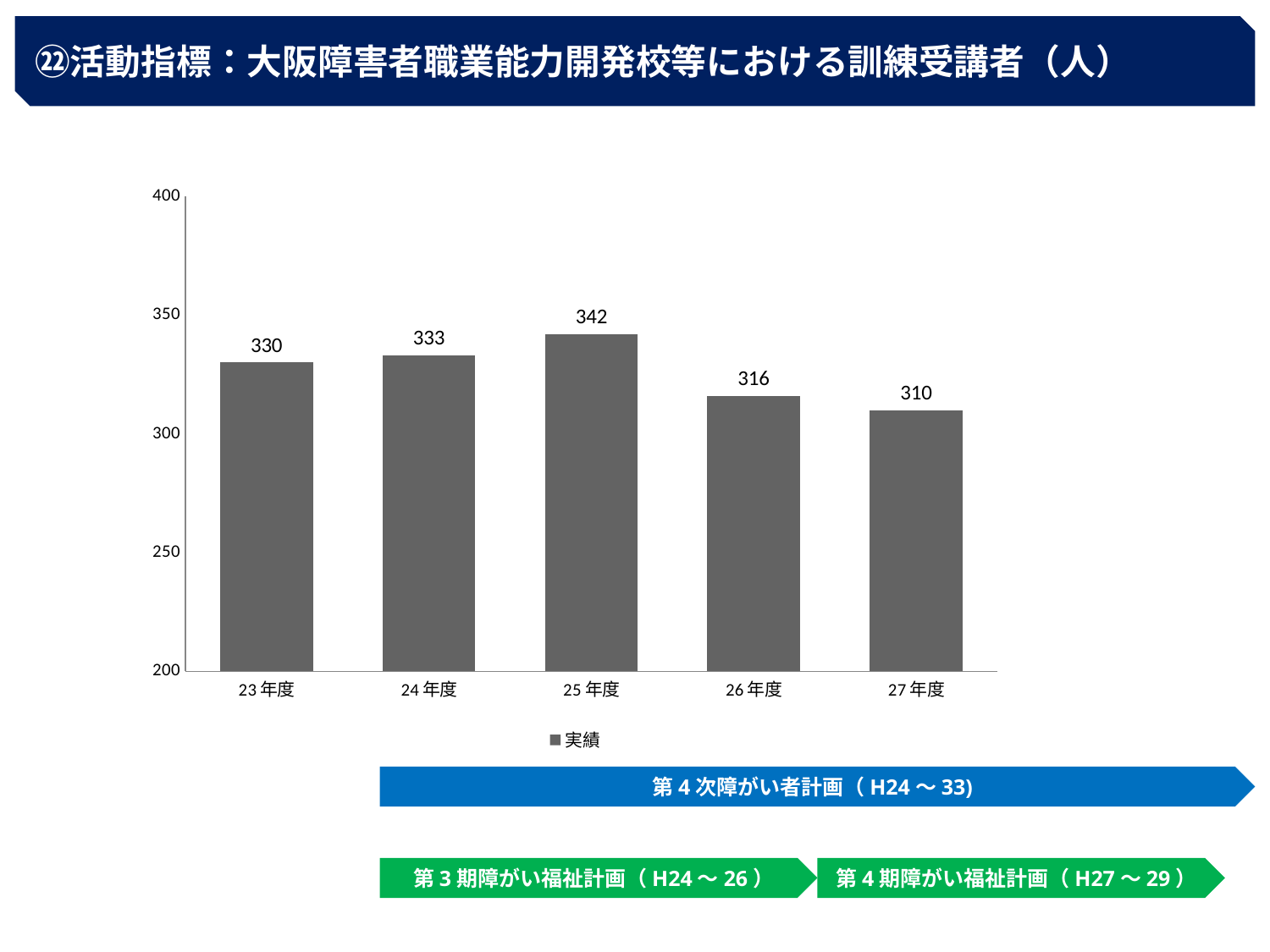
What is the value for 27年度? 310 What kind of chart is shown? bar chart Which is larger, the value for 24年度 or the value for 26年度? 24年度 What is the legend entry for the series? 実績 What is the difference between the values for 25年度 and 26年度? 26 Which year has the lowest value? 27年度 What is the value for 23年度? 330 How many series does the legend list? 1 Which year has the highest value? 25年度 Is the value for 26年度 greater or less than 300? greater What is the value for 25年度? 342 How many years are shown on the x axis? 5